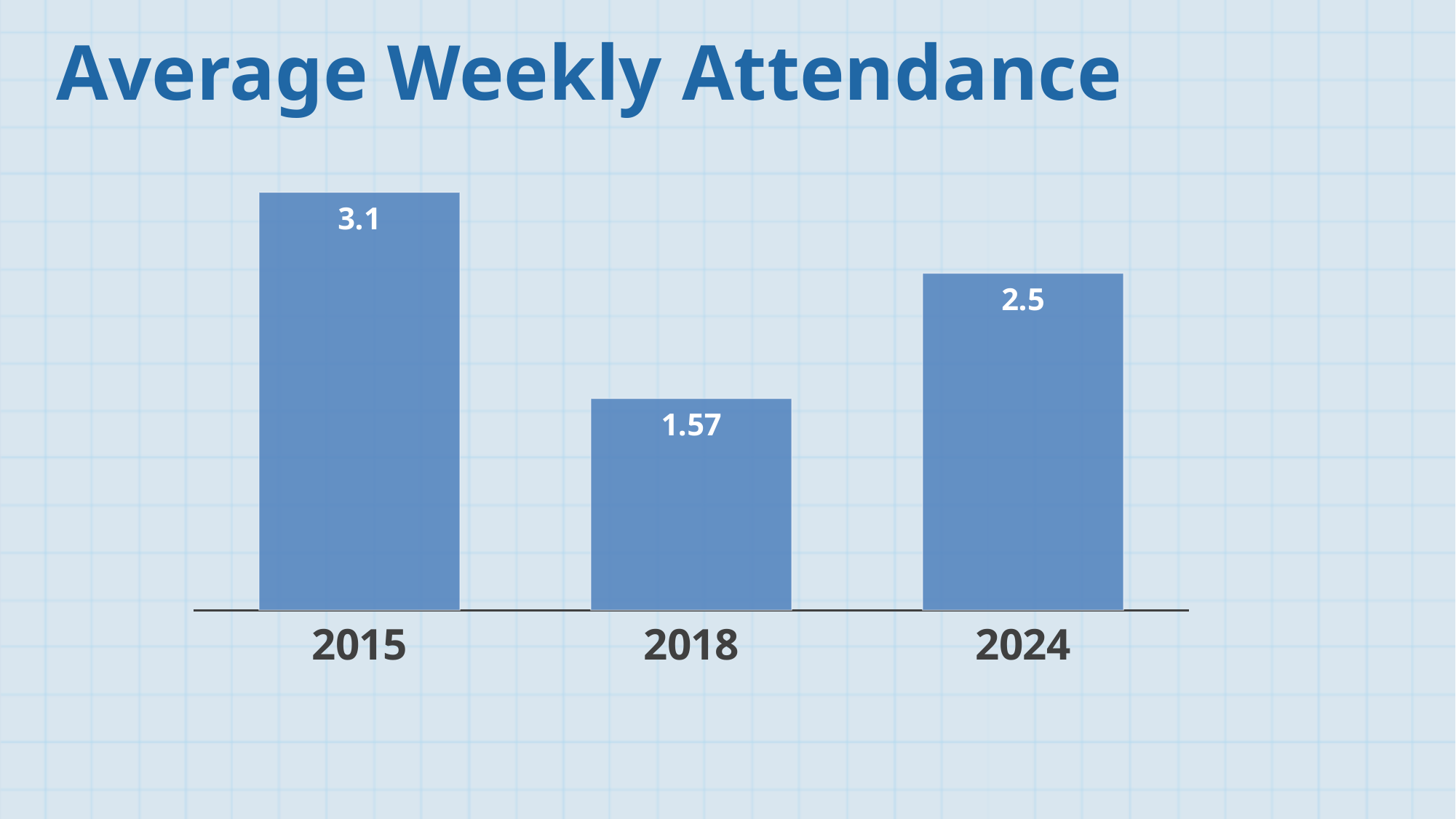
Does the value rise or fall from 2018 to 2024? Rise What is the average weekly attendance value shown for 2015? 3.1 What is the difference between the 2015 and 2018 values? 1.53 What is the difference between the 2024 and 2018 values? 0.93 Which is larger, the value for 2015 or the value for 2024? 2015 What is the average weekly attendance value shown for 2024? 2.5 What is the average weekly attendance value shown for 2018? 1.57 What kind of chart is shown on the slide? Bar chart What is the title of the chart? Average Weekly Attendance Which year has the highest average weekly attendance? 2015 Which year has the lowest average weekly attendance? 2018 How many years are shown on the chart? 3